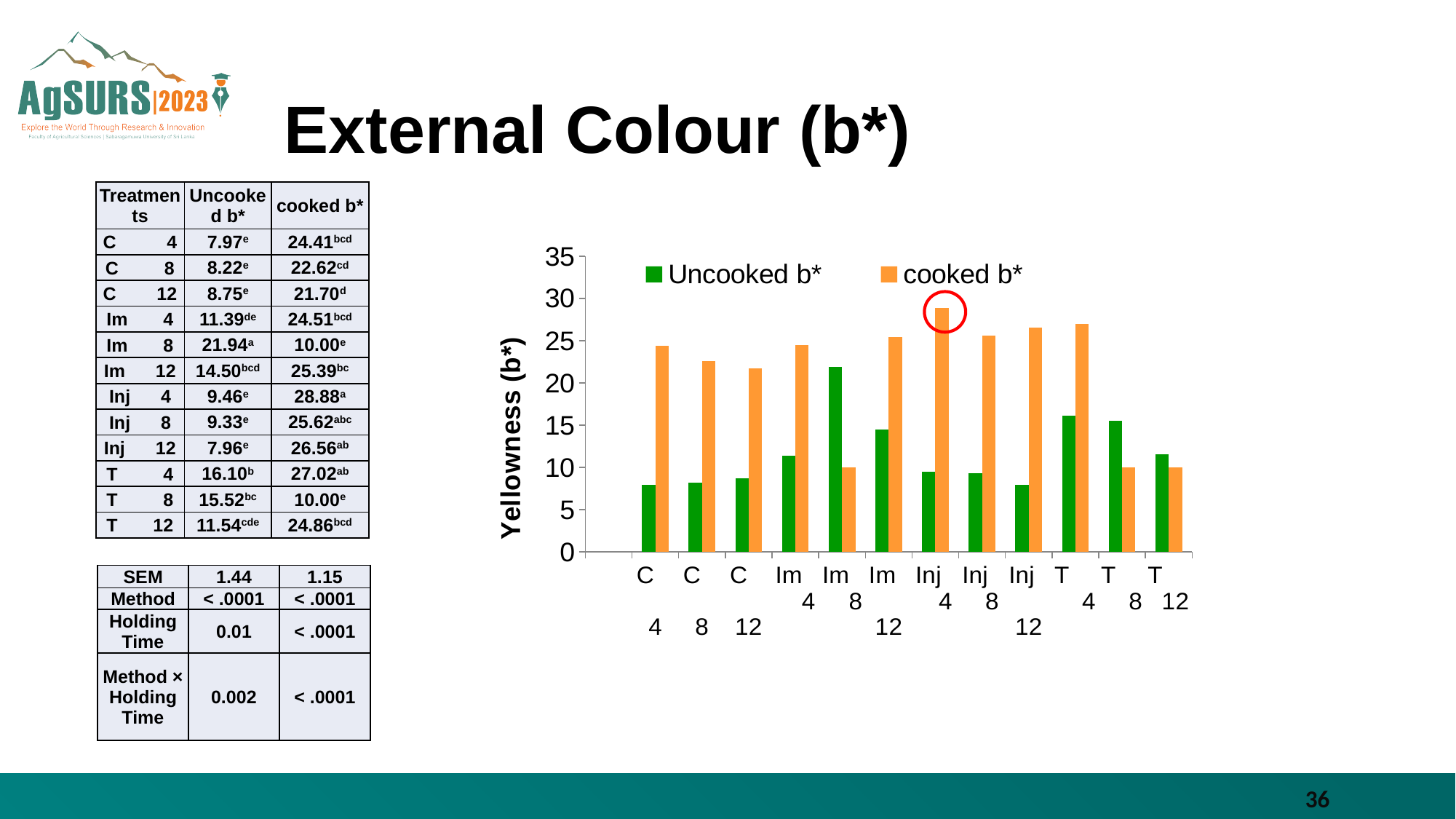
Which treatment has the highest cooked b* bar in the chart? Inj 4 Is the Uncooked b* value for T 4 greater or less than 10? greater What is the title of the chart's y axis? Yellowness (b*) For treatment C 4, which is larger: the Uncooked b* bar or the cooked b* bar? cooked b* What kind of chart is shown on the slide? bar chart How many series does the chart legend list? 2 Which treatment has the highest Uncooked b* bar in the chart? Im 8 How many treatment categories are plotted along the x axis of the chart? 12 For treatment Im 8, which is larger: the Uncooked b* bar or the cooked b* bar? Uncooked b* Is the cooked b* value for C 4 greater or less than 20? greater Is the cooked b* value for Im 8 greater or less than 15? less